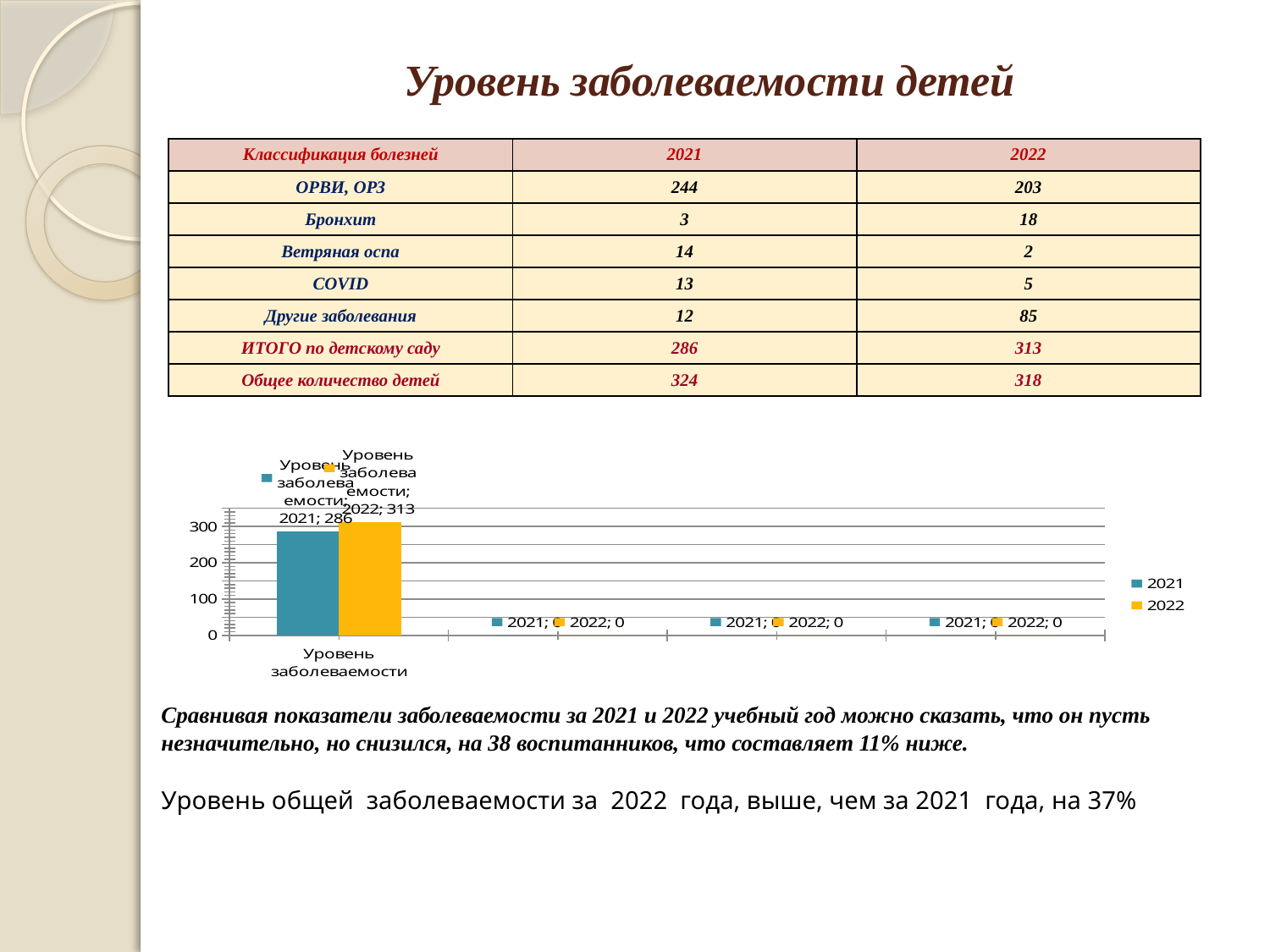
Is the 2021 value for Уровень заболеваемости in the chart greater or less than 300? less Which series in the chart is shown in orange? 2022 What is the label of the category with non-zero bars in the chart? Уровень заболеваемости How many series does the chart legend list? 2 What kind of chart is shown on the slide? bar chart Is the 2022 value for Уровень заболеваемости in the chart greater or less than 300? greater In the chart, which series has the higher value for Уровень заболеваемости, 2021 or 2022? 2022 What are the series names in the chart legend? 2021 and 2022 What is the difference between the 2022 and 2021 values for Уровень заболеваемости in the chart? 27 What is the highest value shown on the chart's vertical axis? 300 What is the value of the 2021 bar for Уровень заболеваемости in the chart? 286 What is the value of the 2022 bar for Уровень заболеваемости in the chart? 313